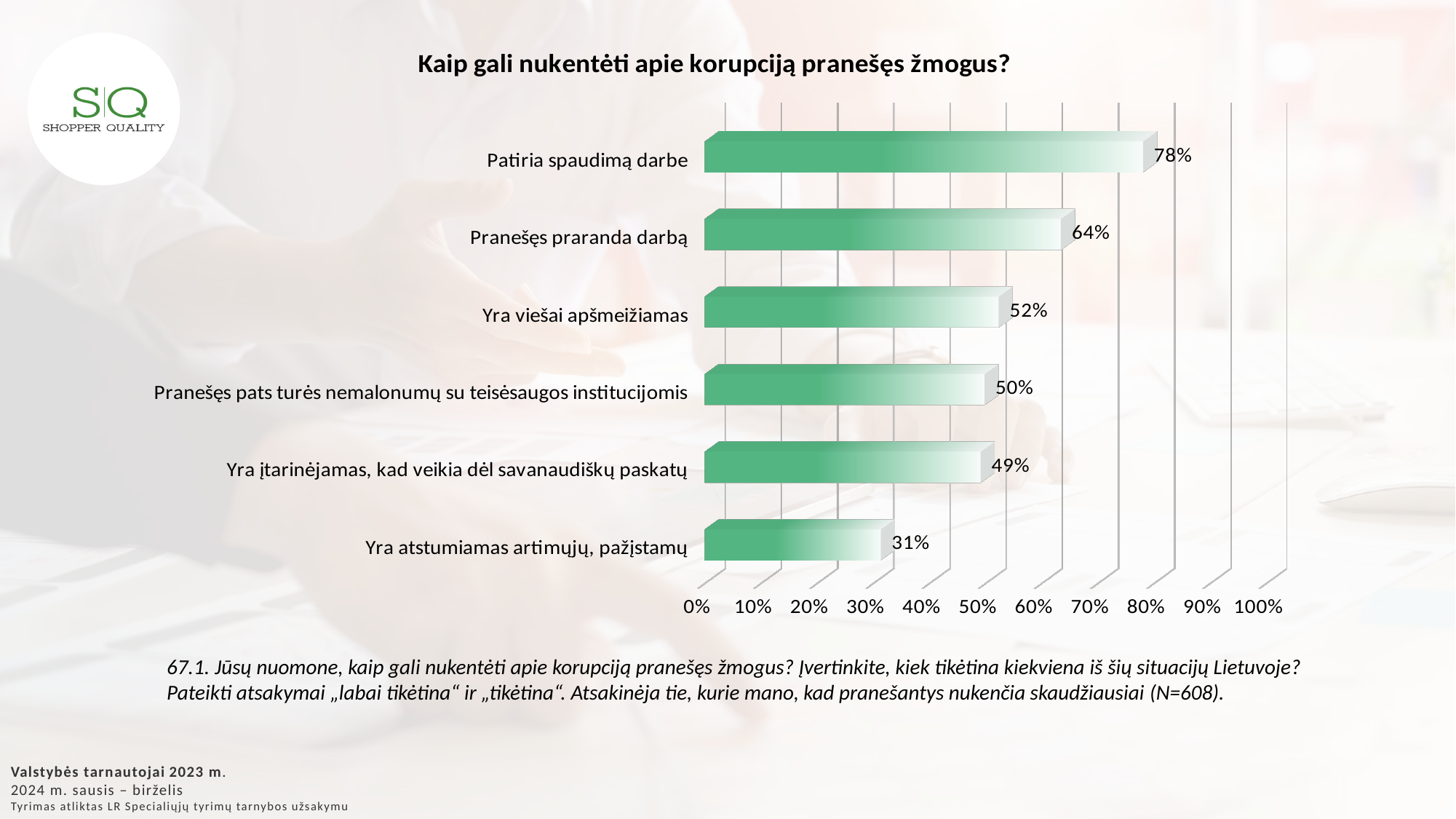
Which is larger: the value for "Yra viešai apšmeižiamas" or the value for "Pranešęs pats turės nemalonumų su teisėsaugos institucijomis"? Yra viešai apšmeižiamas What is the title of the chart? Kaip gali nukentėti apie korupciją pranešęs žmogus? What kind of chart is shown on the slide? Bar chart What is the difference between the values for "Yra viešai apšmeižiamas" and "Yra atstumiamas artimųjų, pažįstamų"? 21% What is the difference between the values for "Patiria spaudimą darbe" and "Pranešęs praranda darbą"? 14% Which category has the lowest value? Yra atstumiamas artimųjų, pažįstamų What is the value for "Yra įtarinėjamas, kad veikia dėl savanaudiškų paskatų"? 49% What is the value for "Pranešęs praranda darbą"? 64% How many categories are shown in the chart? 6 Which category has the highest value? Patiria spaudimą darbe What is the value for "Yra atstumiamas artimųjų, pažįstamų"? 31% What is the value for "Patiria spaudimą darbe"? 78%